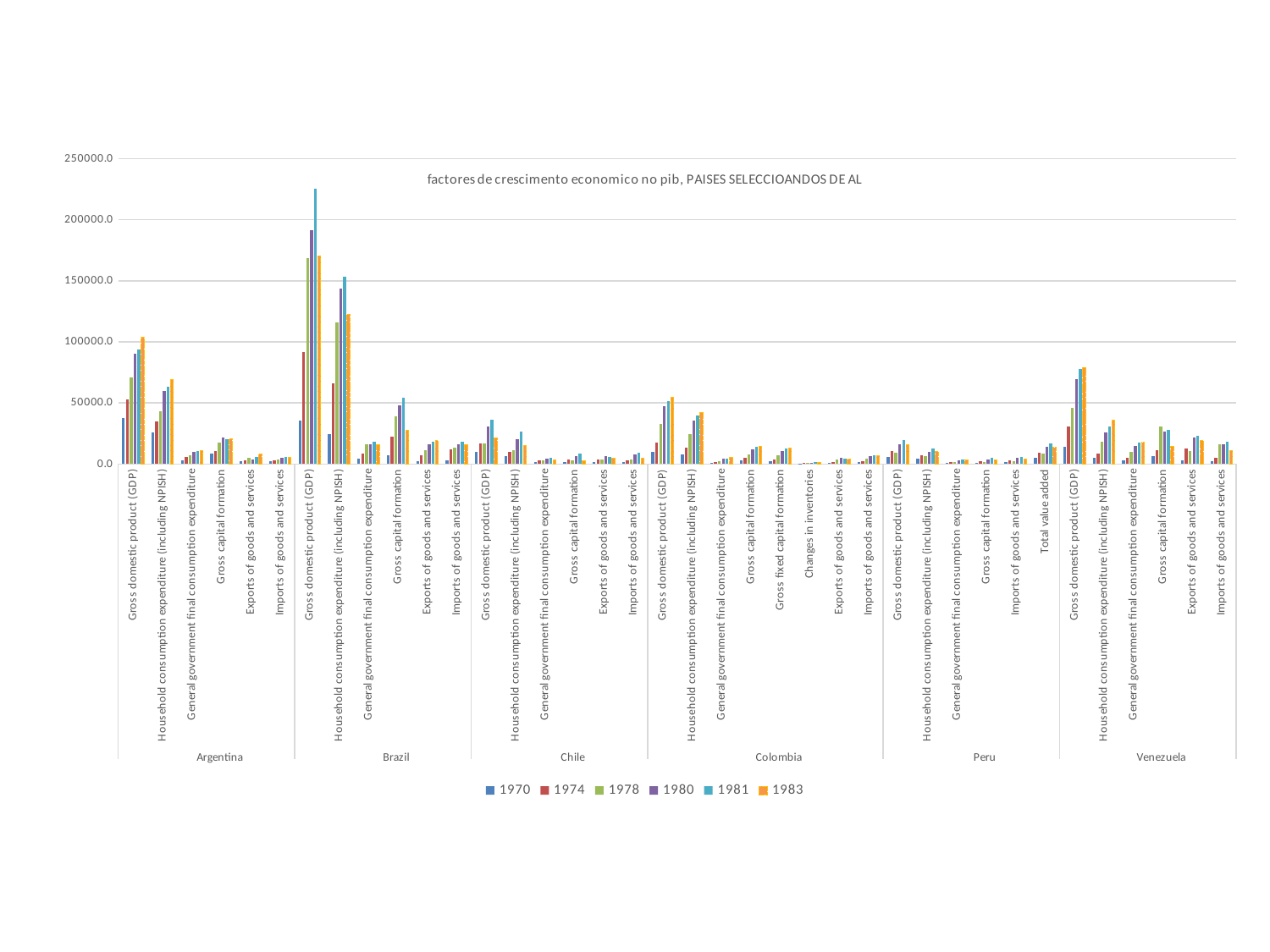
Is the 1981 value for Chile's Gross domestic product (GDP) greater or less than 50000.0? less Which country and indicator has the tallest bar in the chart? Brazil, Gross domestic product (GDP) How many countries are shown along the x axis of the chart? 6 Do the Gross domestic product (GDP) bars for Argentina rise or fall from 1970 to 1983? rise Which is larger in 1981: Brazil's Gross domestic product (GDP) or Argentina's Gross domestic product (GDP)? Brazil's Gross domestic product (GDP) Is the 1983 value for Brazil's Household consumption expenditure (including NPISH) greater or less than 150000.0? less Which years are listed in the chart legend? 1970, 1974, 1978, 1980, 1981, 1983 How many indicator categories are shown for Colombia? 8 Is the 1983 value for Venezuela's Gross domestic product (GDP) greater or less than 50000.0? greater What kind of chart is shown on the slide? bar chart How many series does the legend list? 6